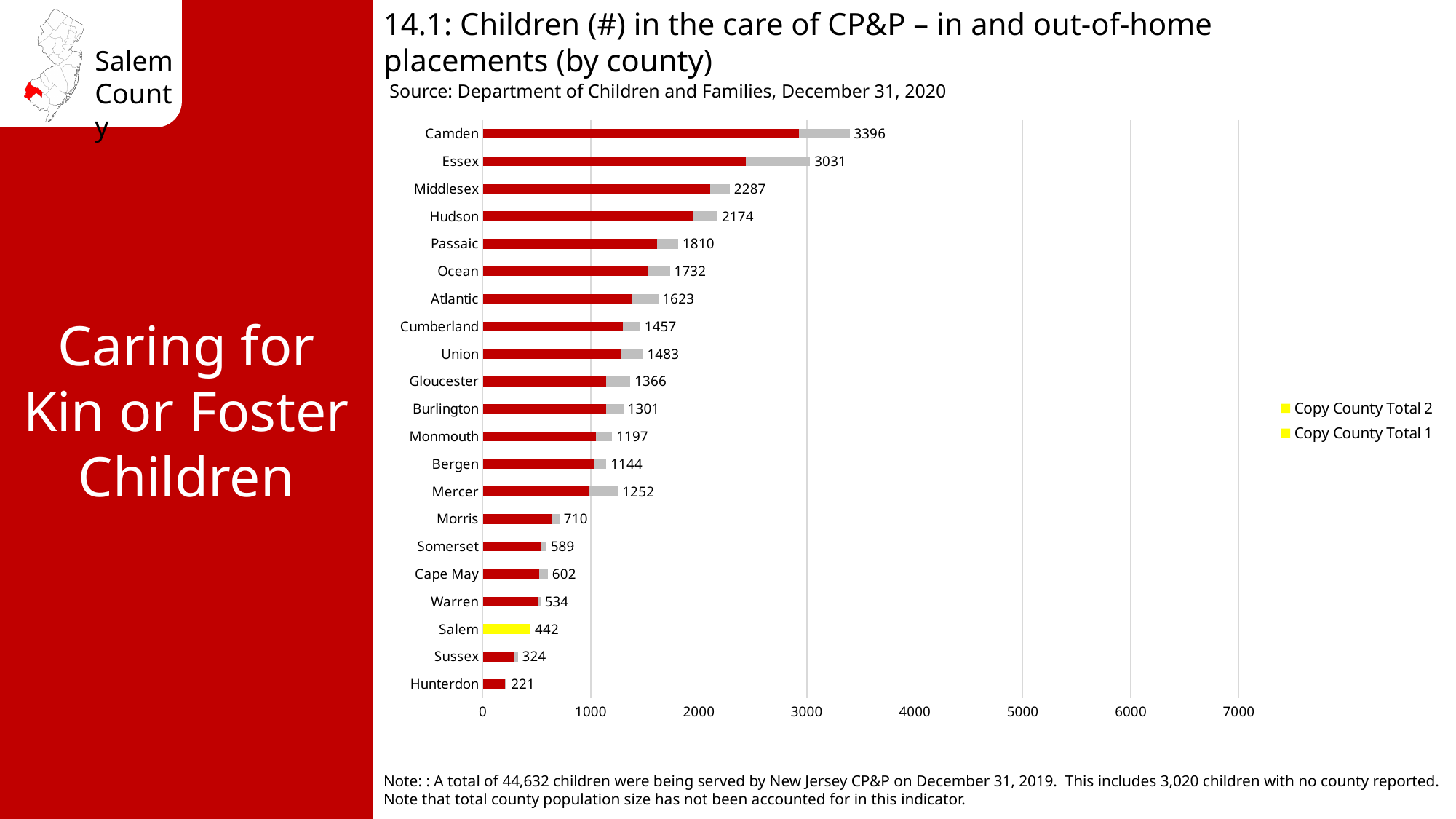
Which county has the highest total number of children in the care of CP&P? Camden Which county has the lowest total number of children in the care of CP&P? Hunterdon What type of chart is used on this slide? Bar chart What is the total number of children in the care of CP&P shown for Salem county? 442 How many entries does the legend list? 2 What is the value labeled for Gloucester? 1366 Which county has a larger total, Union or Cumberland? Union What is the value labeled for Camden? 3396 What is the difference between the totals for Salem and Sussex? 118 What is the difference between the totals for Camden and Essex? 365 Is the total for Hudson greater or less than 2000? greater How many counties are shown on the chart? 21